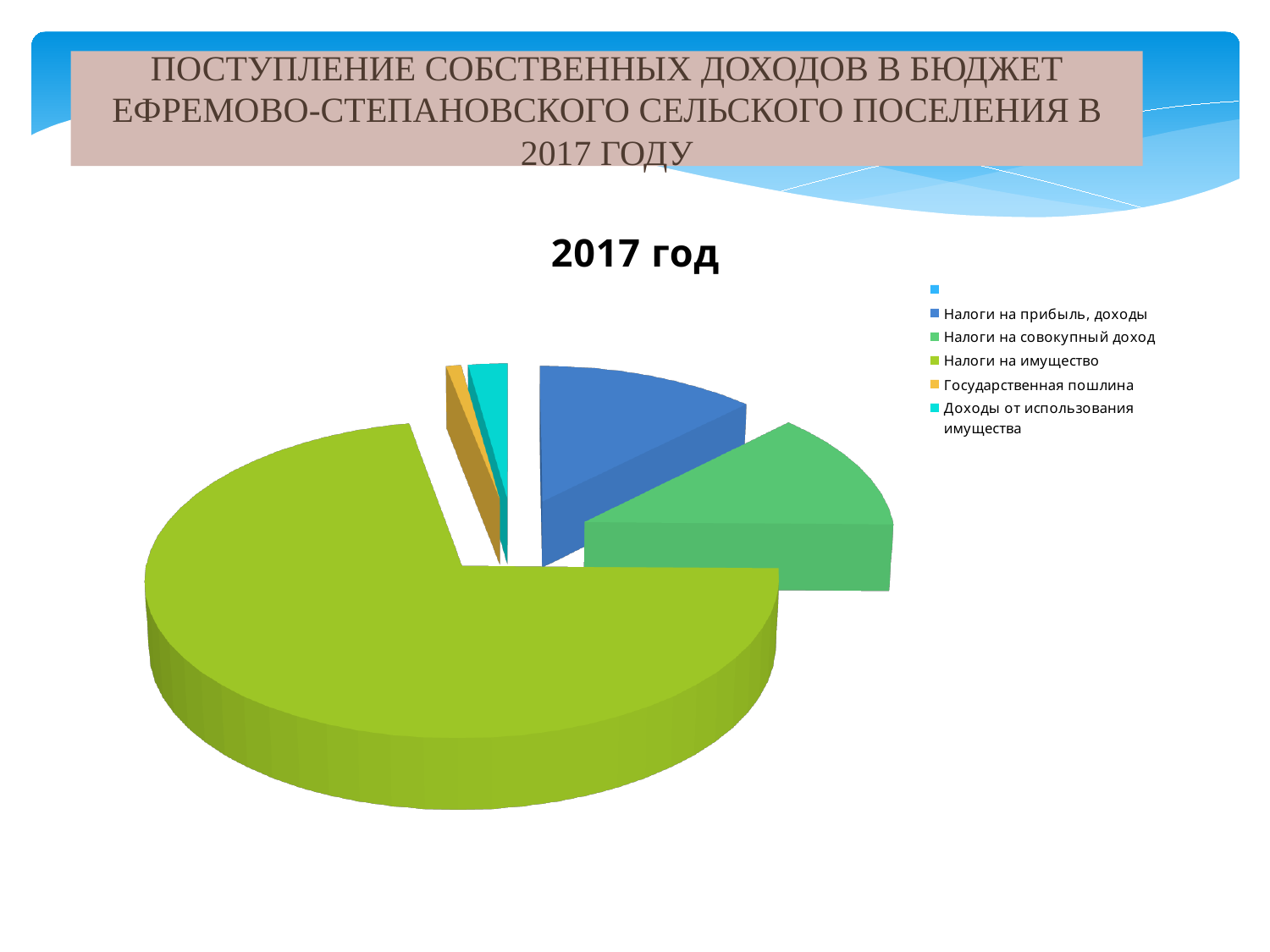
How many named categories does the legend list? 5 Which is larger: the slice for Налоги на прибыль, доходы or the slice for Доходы от использования имущества? Налоги на прибыль, доходы What kind of chart is shown on the slide? pie chart Does the slice for Налоги на имущество take up more or less than half of the pie? more Which is larger: the slice for Налоги на совокупный доход or the slice for Государственная пошлина? Налоги на совокупный доход What is the title of the chart? 2017 год Which category has the largest slice of the pie? Налоги на имущество What colour is the slice for Налоги на прибыль, доходы? blue Which is larger: the slice for Налоги на имущество or the slice for Налоги на прибыль, доходы? Налоги на имущество